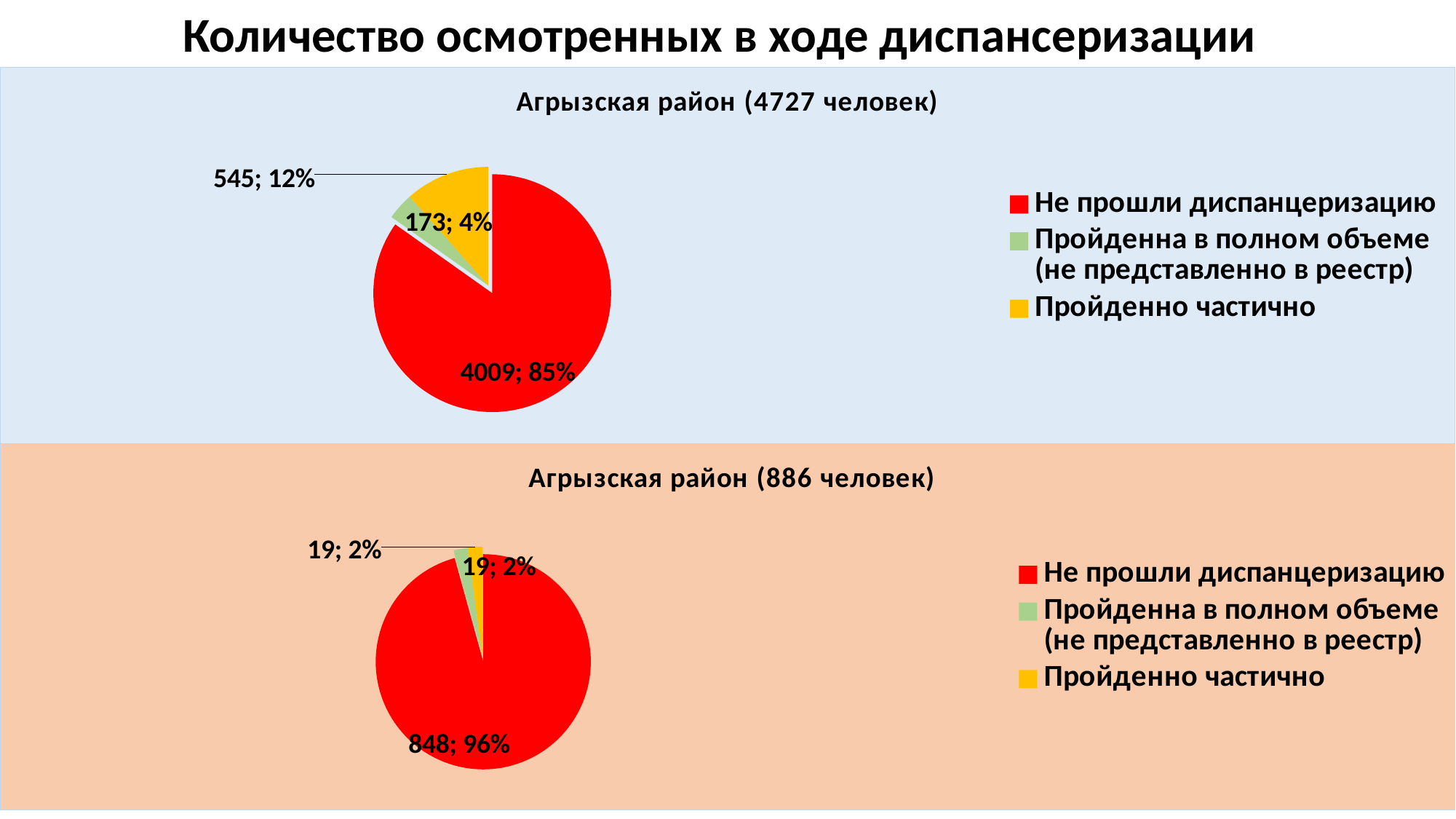
What kind of chart is the top chart, 'Агрызская район (4727 человек)'? Pie chart In the top chart (4727 человек), what is the value for 'Пройденна в полном объеме (не представленно в реестр)'? 173 In the top chart (4727 человек), what share of the pie is 'Пройденно частично'? 12% In the top chart (4727 человек), what is the difference between 'Пройденно частично' and 'Пройденна в полном объеме (не представленно в реестр)'? 372 In the bottom chart (886 человек), how many people are in the 'Не прошли диспанцеризацию' slice? 848 In the bottom chart (886 человек), what share of the pie is 'Не прошли диспанцеризацию'? 96% In the top chart (4727 человек), which category is the smallest? Пройденна в полном объеме (не представленно в реестр) In the bottom chart (886 человек), which category is the largest? Не прошли диспанцеризацию How many entries does the legend of the top chart (4727 человек) list? 3 In the top chart (4727 человек), how many people are in the 'Не прошли диспанцеризацию' slice? 4009 In the bottom chart (886 человек), what is the value for 'Пройденно частично'? 19 How many slices does the bottom chart (886 человек) have? 3